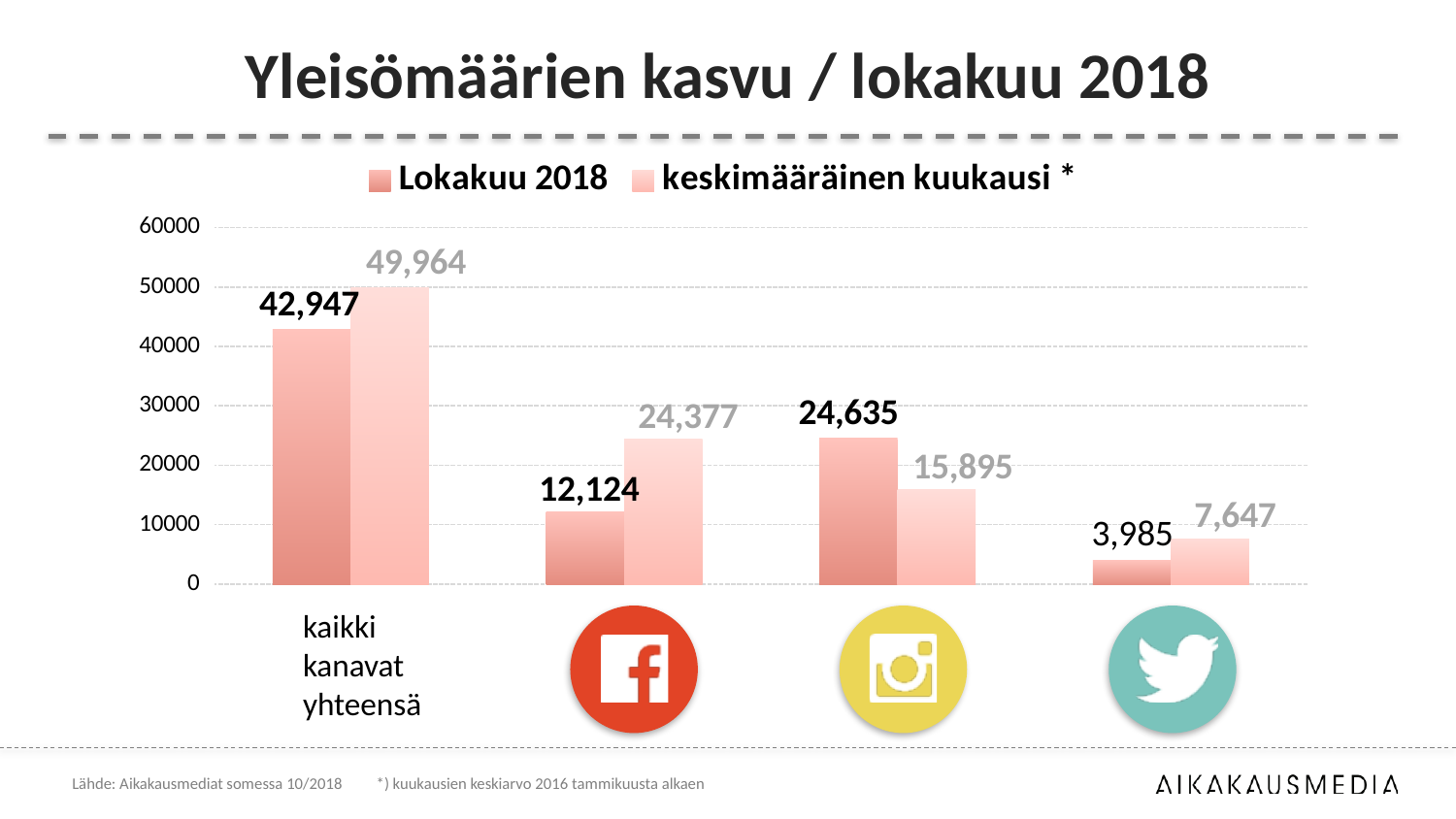
What is the value for keskimääräinen kuukausi * in the 'kaikki kanavat yhteensä' category? 49,964 Which category has the highest keskimääräinen kuukausi * value? kaikki kanavat yhteensä Is the Lokakuu 2018 value for the Facebook category (second group) greater or less than 20000? less What is the difference between the keskimääräinen kuukausi * and Lokakuu 2018 values for the Facebook category (second group)? 12,253 Which category has the lowest Lokakuu 2018 value? Twitter (fourth group) How many categories are shown on the x axis? 4 For the Instagram category (third group), which is larger: Lokakuu 2018 or keskimääräinen kuukausi *? Lokakuu 2018 How many series does the legend list? 2 What is the value for Lokakuu 2018 in the 'kaikki kanavat yhteensä' category? 42,947 What is the keskimääräinen kuukausi * value for the Twitter category (fourth group)? 7,647 What is the Lokakuu 2018 value for the Instagram category (third group)? 24,635 What kind of chart is shown on the slide? bar chart